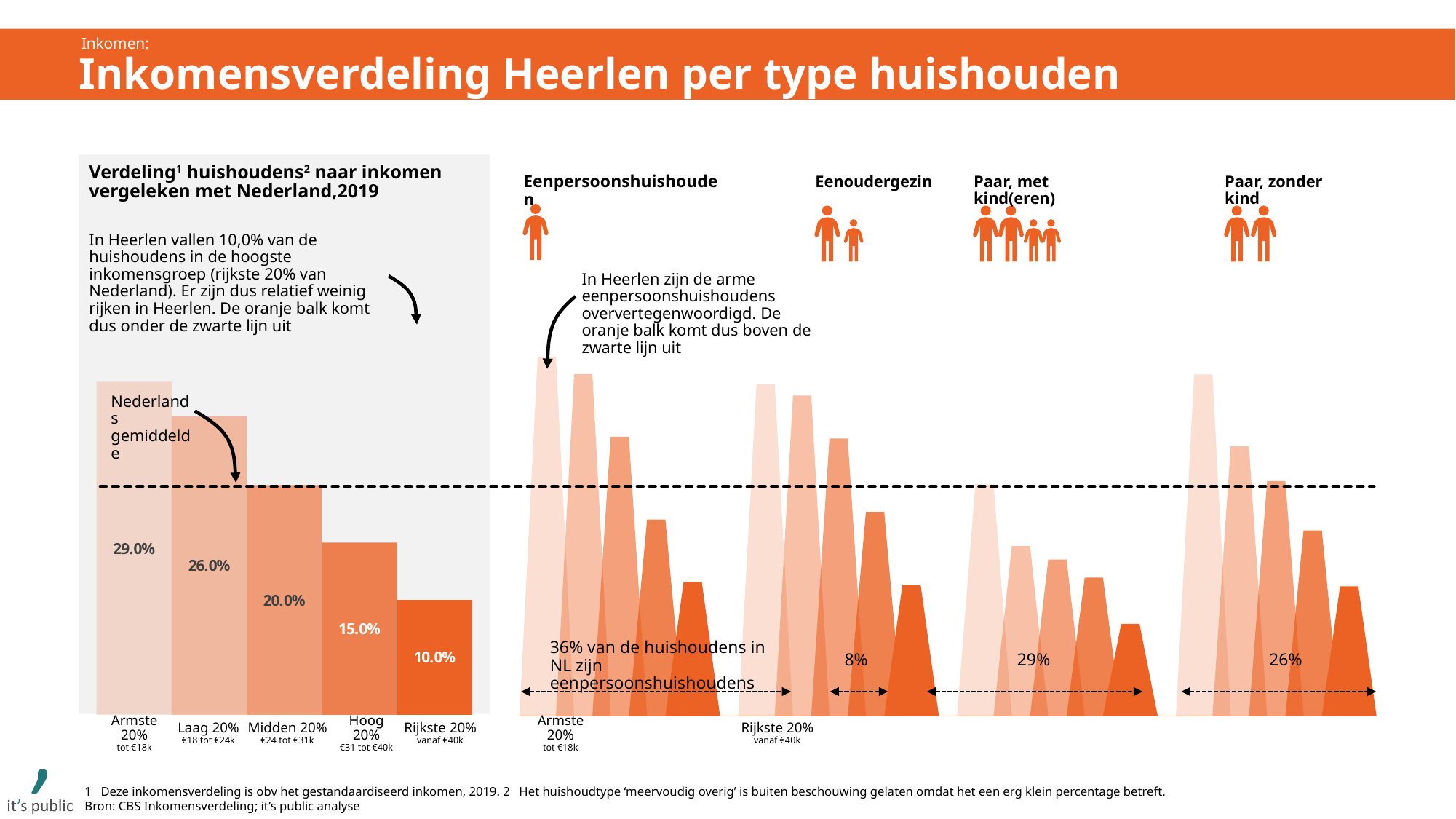
In the left chart 'Verdeling huishoudens naar inkomen vergeleken met Nederland, 2019', do the values rise or fall from Armste 20% to Rijkste 20%? fall In the right-hand charts, what percentage of households in NL are eenpersoonshuishoudens? 36% In the left chart 'Verdeling huishoudens naar inkomen vergeleken met Nederland, 2019', what is the value for Midden 20%? 20.0% In the left chart 'Verdeling huishoudens naar inkomen vergeleken met Nederland, 2019', what is the value for Rijkste 20%? 10.0% In the left chart 'Verdeling huishoudens naar inkomen vergeleken met Nederland, 2019', what is the difference between the values for Laag 20% and Hoog 20%? 11.0% In the left chart 'Verdeling huishoudens naar inkomen vergeleken met Nederland, 2019', how many income groups are shown? 5 In the right-hand charts, what percentage is shown for the household type 'Paar, met kind(eren)'? 29% In the left chart 'Verdeling huishoudens naar inkomen vergeleken met Nederland, 2019', which income group has the lowest value? Rijkste 20% In the left chart 'Verdeling huishoudens naar inkomen vergeleken met Nederland, 2019', which income group has the highest value? Armste 20% In the left chart 'Verdeling huishoudens naar inkomen vergeleken met Nederland, 2019', what is the value for Armste 20%? 29.0% In the left chart 'Verdeling huishoudens naar inkomen vergeleken met Nederland, 2019', which is larger: the value for Laag 20% or the value for Midden 20%? Laag 20% What kind of chart is the left chart 'Verdeling huishoudens naar inkomen vergeleken met Nederland, 2019'? bar chart